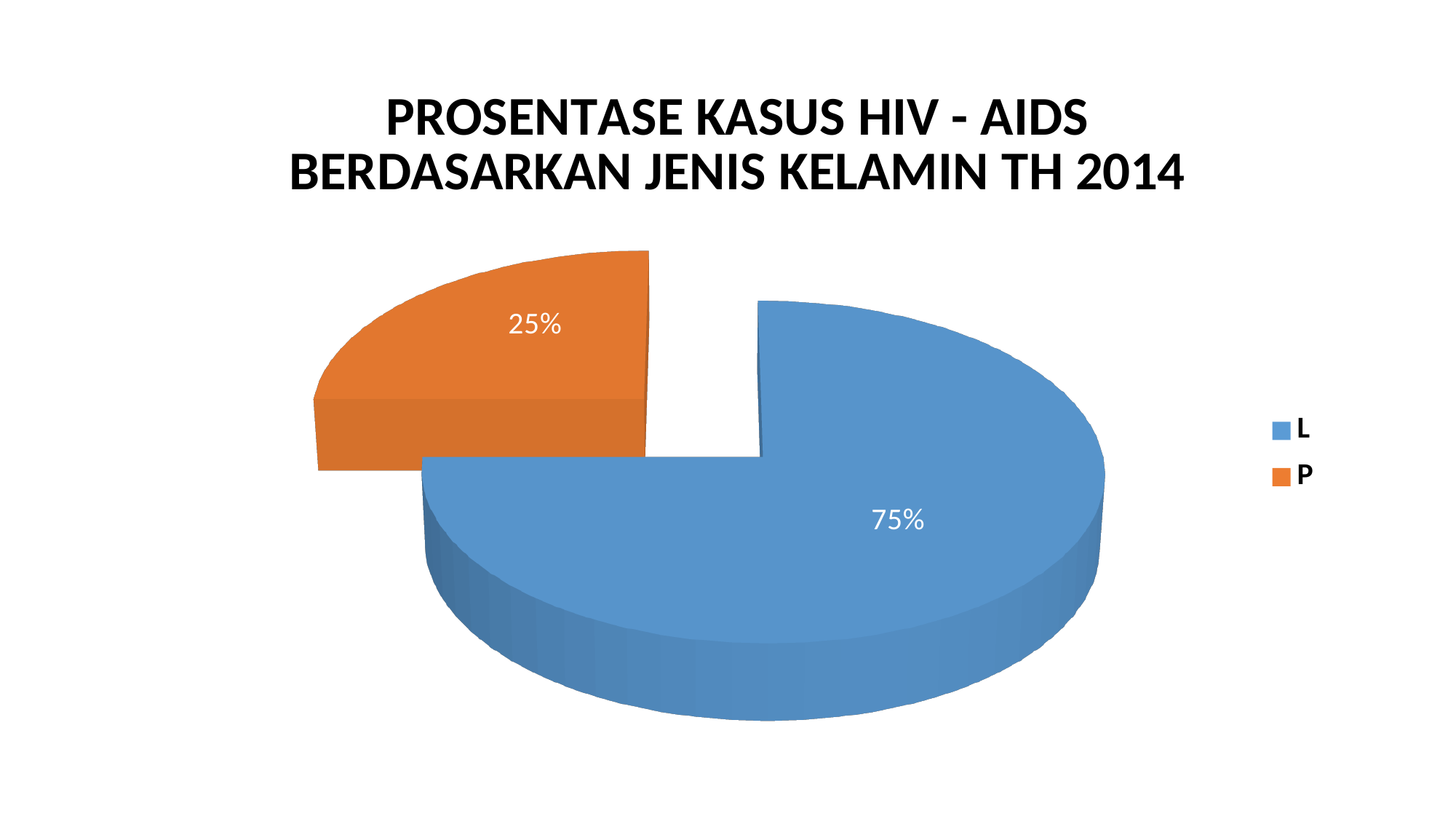
What kind of chart is shown on the slide? Pie chart How many entries does the legend list? 2 Which category has the largest slice of the pie? L How many slices does the pie chart have? 2 What share of the pie does the P slice represent? 25% Which category has the smallest slice of the pie? P Which slice is larger, L or P? L What is the title of the chart? PROSENTASE KASUS HIV - AIDS BERDASARKAN JENIS KELAMIN TH 2014 What share of the pie does the L slice represent? 75% What is the difference in percentage points between the L and P slices? 50 What colour is the slice for P? Orange